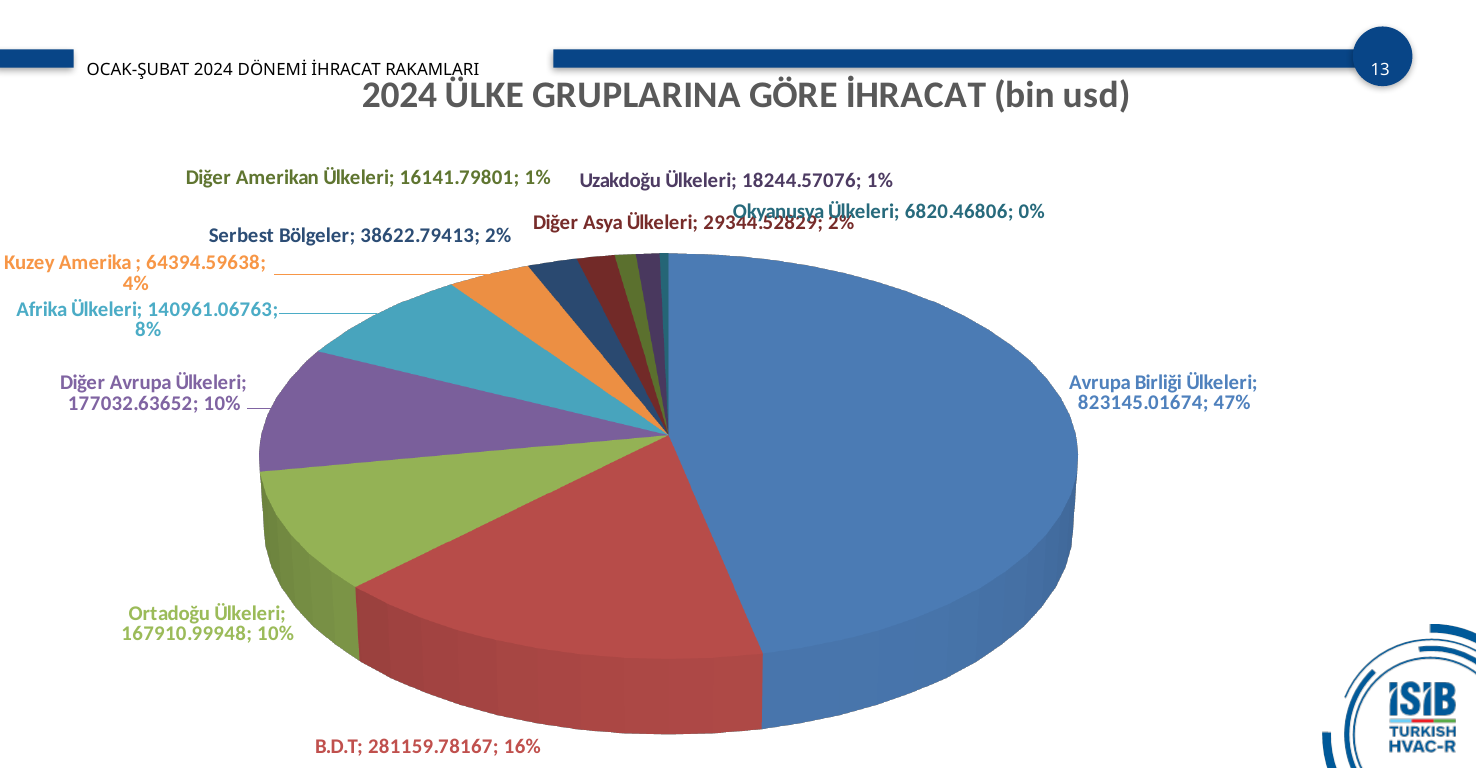
Which country group has the smallest slice of the pie? Okyanusya Ülkeleri What share of the pie does Ortadoğu Ülkeleri represent? 10% What is the export value for B.D.T? 281159.78167 What is the title of the chart? 2024 ÜLKE GRUPLARINA GÖRE İHRACAT (bin usd) Which country group has the largest slice of the pie? Avrupa Birliği Ülkeleri What kind of chart is shown on the slide? pie chart What is the export value for Avrupa Birliği Ülkeleri? 823145.01674 How many country groups (slices) are shown in the pie chart? 11 What is the difference between the export values of Avrupa Birliği Ülkeleri and B.D.T? 541985.23507 What is the export value for Afrika Ülkeleri? 140961.06763 What share of the pie does Kuzey Amerika represent? 4% Which is larger, the export value for B.D.T or for Ortadoğu Ülkeleri? B.D.T